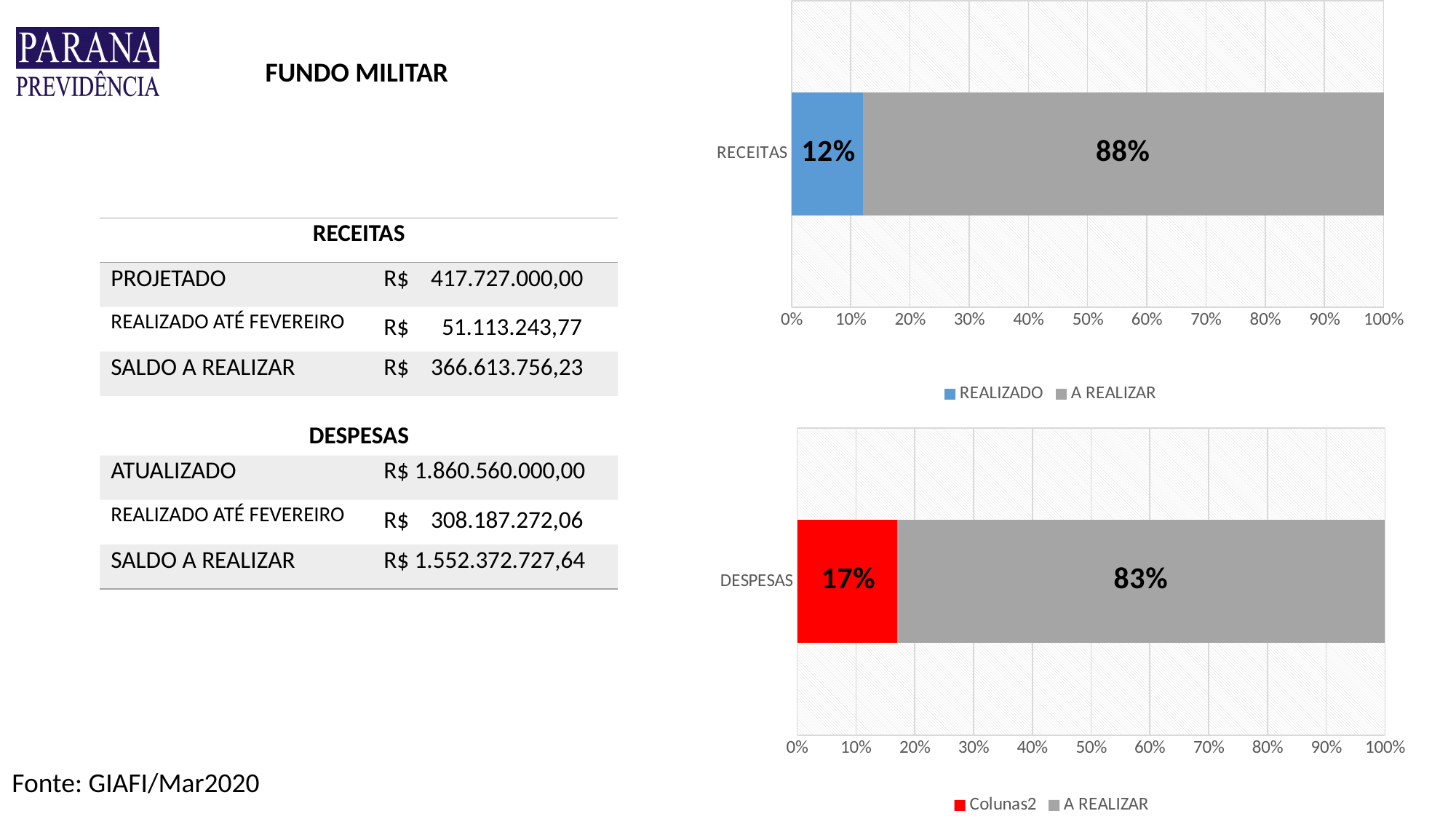
In the top chart (RECEITAS), what percentage is shown for A REALIZAR? 88% In the bottom chart (DESPESAS), what percentage is shown for the red segment (Colunas2)? 17% What are the legend entries of the bottom chart (DESPESAS)? Colunas2 and A REALIZAR In the top chart (RECEITAS), what is the difference between the A REALIZAR segment and the REALIZADO segment? 76% In the bottom chart (DESPESAS), what percentage is shown for A REALIZAR? 83% In the top chart (RECEITAS), which segment is larger, REALIZADO or A REALIZAR? A REALIZAR What kind of chart is the bottom chart (DESPESAS)? Stacked bar chart In the bottom chart (DESPESAS), what is the difference between the A REALIZAR segment and the Colunas2 segment? 66% In the bottom chart (DESPESAS), is the value for the red segment greater or less than 20%? less In the top chart (RECEITAS), what is the total of the stacked bar? 100% In the top chart (RECEITAS), what percentage is shown for REALIZADO? 12% How many series does the legend of the top chart (RECEITAS) list? 2